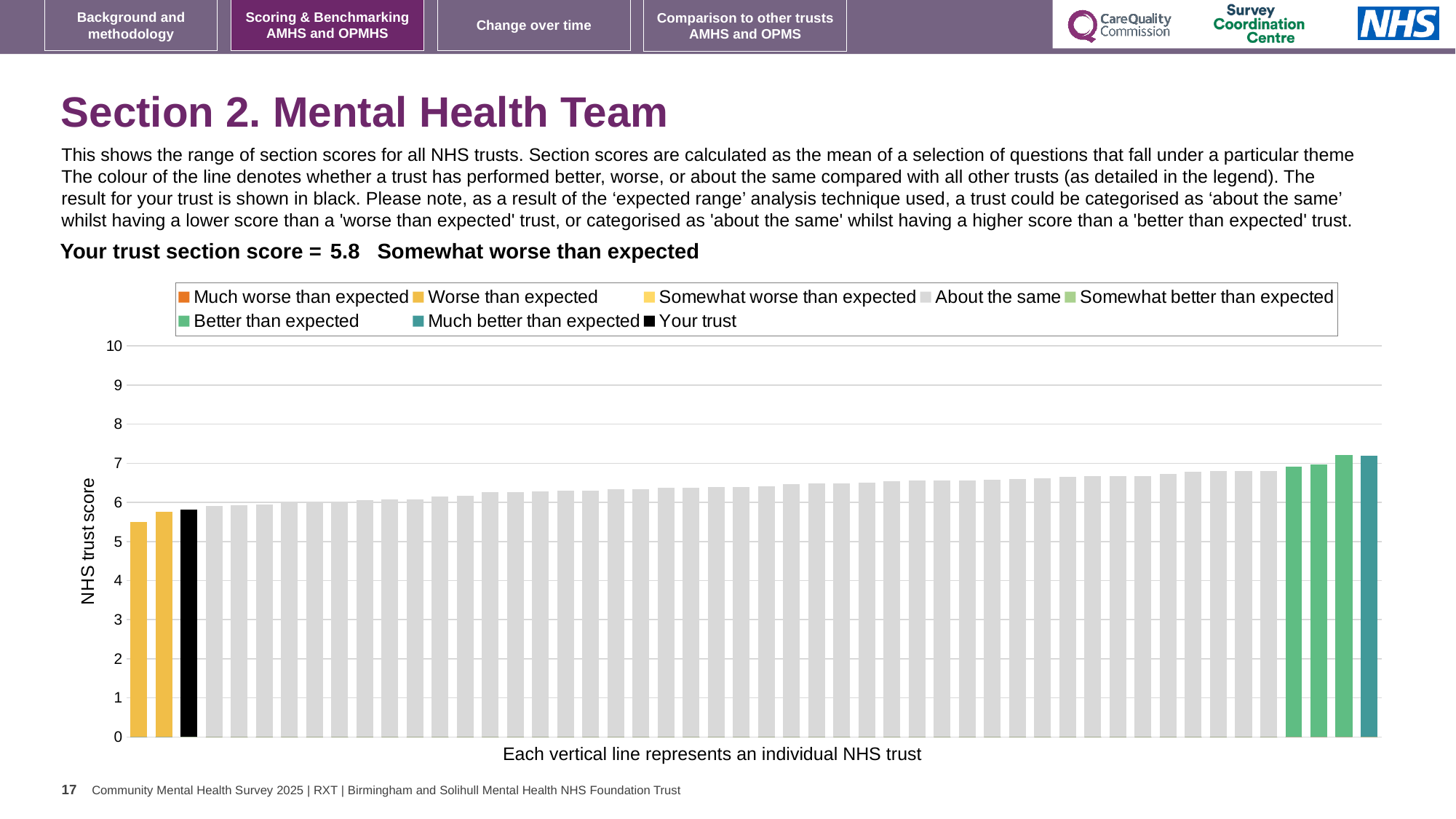
Is the shortest bar in the chart greater or less than 5? greater Which is taller: the bar for your trust or the leftmost bar in the chart? the bar for your trust Do the bar values rise or fall from left to right across the chart? rise What is the label on the vertical axis of the chart? NHS trust score Is the tallest bar in the chart greater or less than 8? less What colour is the bar representing your trust? black How many bars are coloured yellow (worse than expected) in the chart? 2 What kind of chart is shown on the slide? bar chart Is the value for your trust greater or less than 5? greater What is the section score for your trust shown on the slide? 5.8 How many entries does the chart legend list? 8